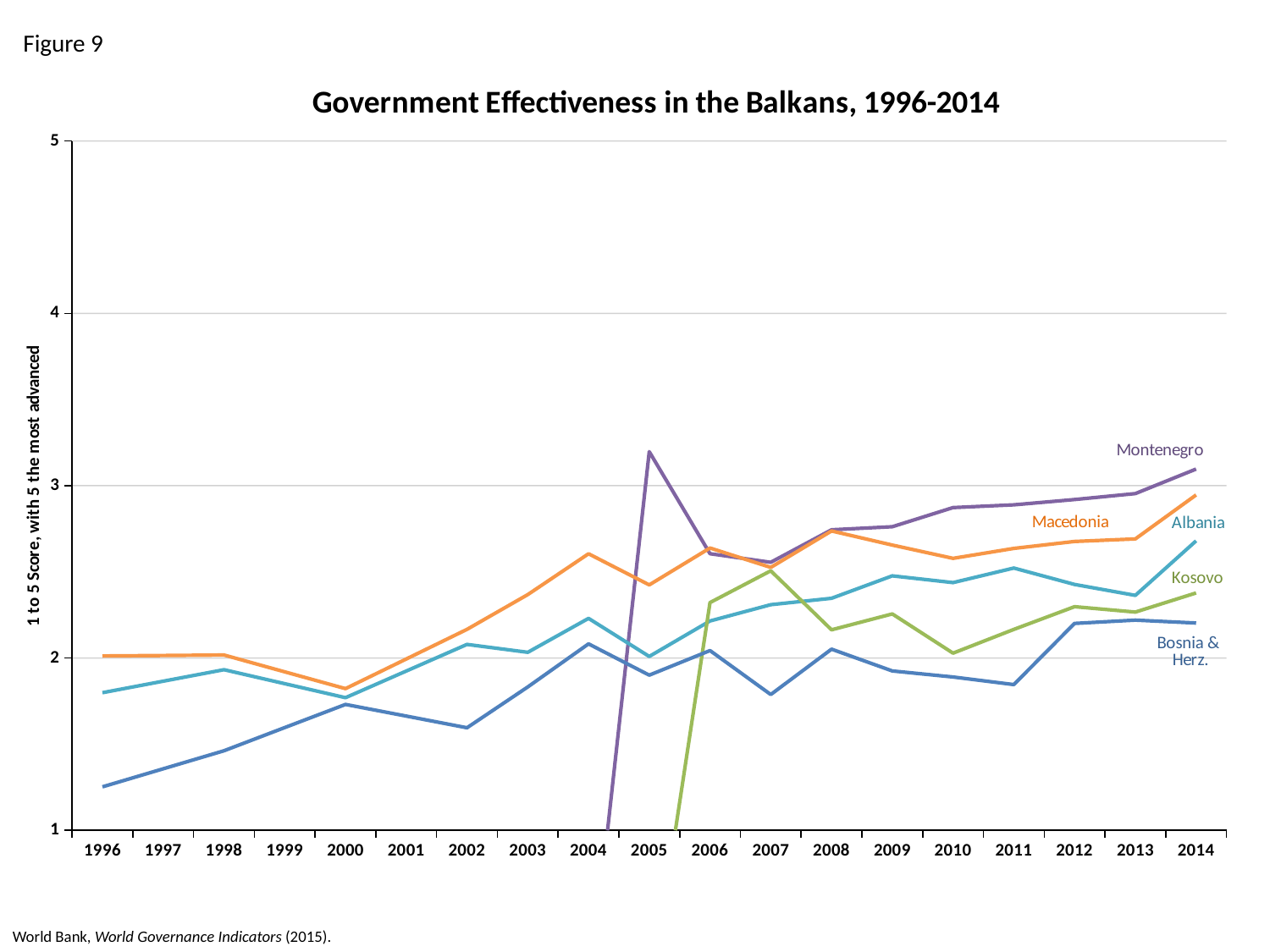
How many years are shown along the x axis? 19 Is the value for Bosnia & Herz. in 2007 greater or less than 2? less Which country has the lowest government effectiveness score in 2014? Bosnia & Herz. Does the line for Bosnia & Herz. rise or fall overall from 1996 to 2014? rise Which country has the highest government effectiveness score in 2014? Montenegro In 2004, which is larger: the value for Macedonia or the value for Bosnia & Herz.? Macedonia Is the value for Montenegro in 2005 greater or less than 3? greater Is the value for Bosnia & Herz. in 1996 greater or less than 2? less What kind of chart is shown on the slide? line chart How many countries (series) are plotted on the chart? 5 What is the title of the chart? Government Effectiveness in the Balkans, 1996-2014